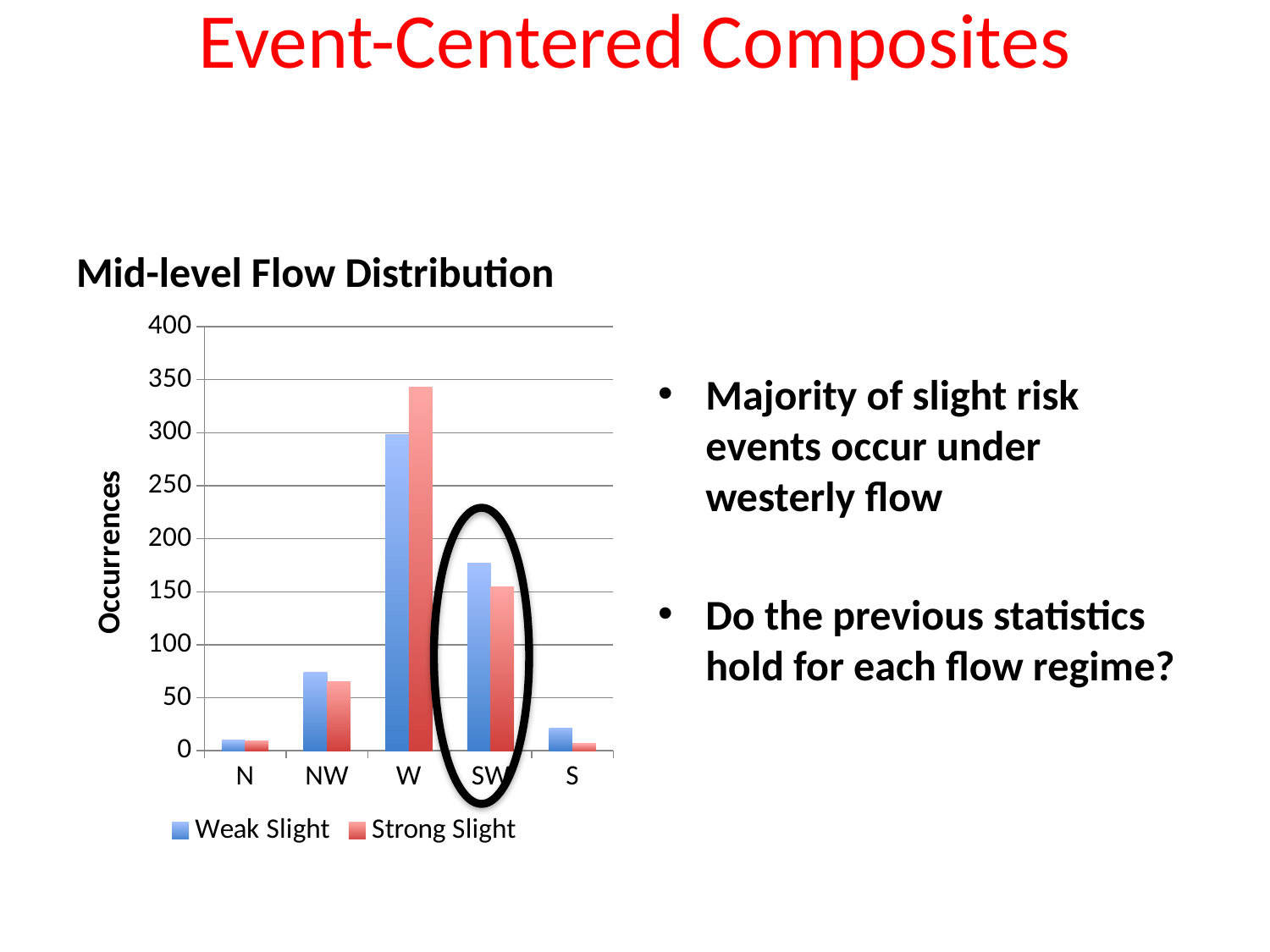
Which flow direction has the highest number of Weak Slight occurrences? W For the W category, which series has more occurrences, Weak Slight or Strong Slight? Strong Slight Which flow direction has the highest number of Strong Slight occurrences? W Is the Strong Slight value for W greater or less than 300? greater Is the Weak Slight value for SW greater or less than 150? greater How many series does the legend of the Mid-level Flow Distribution chart list? 2 How many flow direction categories are shown on the x axis of the Mid-level Flow Distribution chart? 5 What type of chart is shown on the slide? bar chart Is the Weak Slight value for S greater or less than 50? less For the SW category, which series has more occurrences, Weak Slight or Strong Slight? Weak Slight What is the label on the vertical axis of the Mid-level Flow Distribution chart? Occurrences Which flow direction has the lowest number of Weak Slight occurrences? N